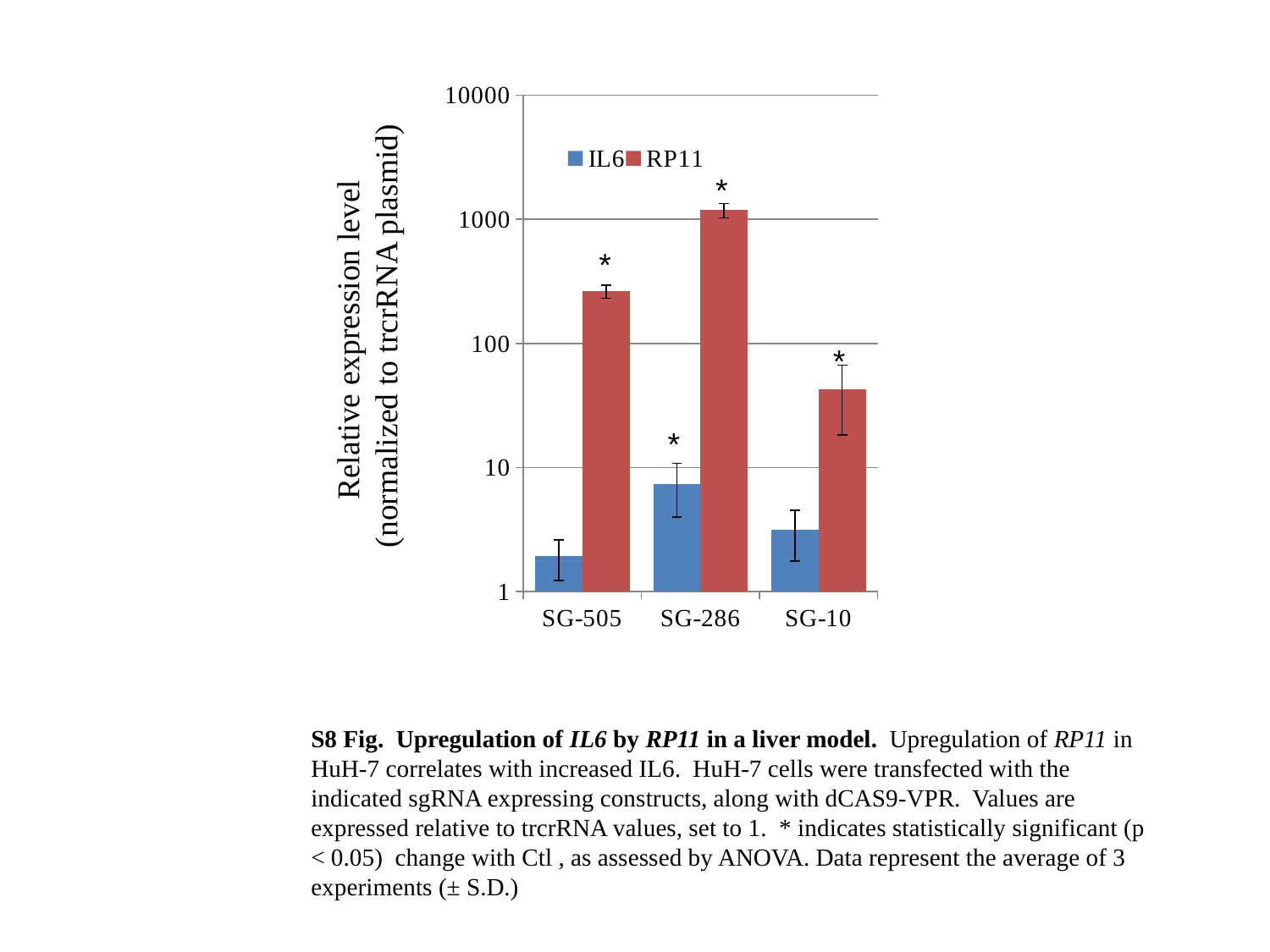
Is the RP11 value for SG-505 greater or less than 100? greater How many categories are shown on the x axis? 3 What is the title of the y axis? Relative expression level (normalized to trcrRNA plasmid) Is the RP11 value for SG-10 greater or less than 100? less Which category has the highest RP11 value? SG-286 Which category has the highest IL6 value? SG-286 What kind of chart is shown on the slide? bar chart For SG-505, which series has the larger value, IL6 or RP11? RP11 Is the RP11 value for SG-286 greater or less than 1000? greater How many series does the legend list? 2 Which category has the lowest RP11 value? SG-10